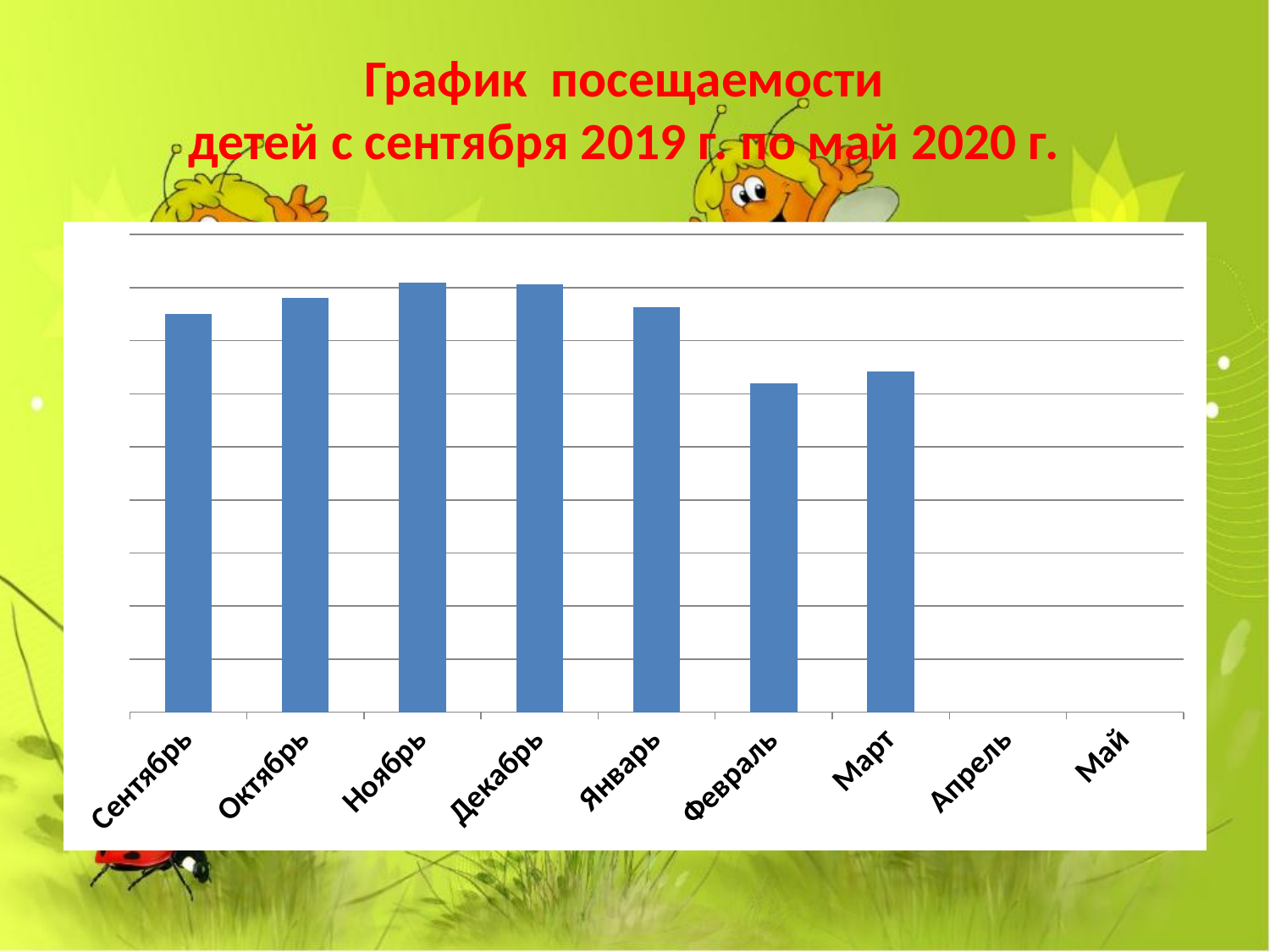
Which is larger, the value for Декабрь or the value for Февраль? Декабрь Which is larger, the value for Сентябрь or the value for Октябрь? Октябрь Do the values rise or fall from Сентябрь to Ноябрь? Rise What is the title of the slide above the chart? График посещаемости детей с сентября 2019 г. по май 2020 г. Do the values rise or fall from Декабрь to Февраль? Fall Which months on the x axis have no bar plotted? Апрель and Май What kind of chart is shown on the slide? Bar chart How many months have a bar plotted in the chart? 7 Which is larger, the value for Февраль or the value for Март? Март How many months are labelled on the x axis of the chart? 9 Among the months with a plotted bar, which month has the lowest value? Февраль